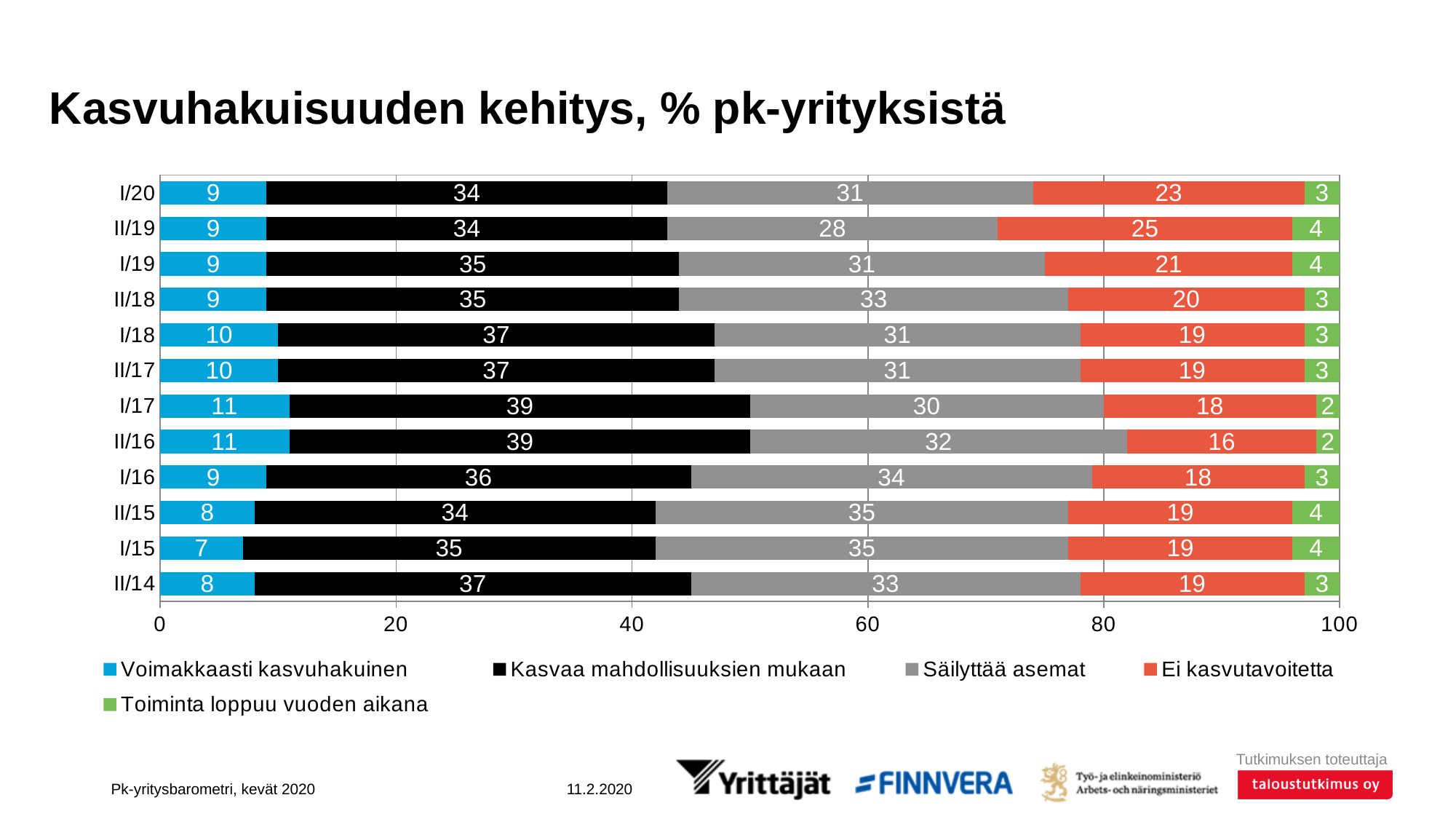
Which period has the highest value for Ei kasvutavoitetta? II/19 What is the title of the chart? Kasvuhakuisuuden kehitys, % pk-yrityksistä What is the difference between the Säilyttää asemat values for I/20 and II/19? 3 What kind of chart is shown on the slide? Stacked bar chart What is the value of Voimakkaasti kasvuhakuinen for I/17? 11 What is the value of Toiminta loppuu vuoden aikana for II/16? 2 Which period has the larger Kasvaa mahdollisuuksien mukaan value, I/17 or I/20? I/17 How many periods are shown on the chart? 12 Which period has the lowest value for Voimakkaasti kasvuhakuinen? I/15 What is the total of the stacked bar for I/20? 100 How many series does the legend list? 5 What is the value of Ei kasvutavoitetta for II/19? 25